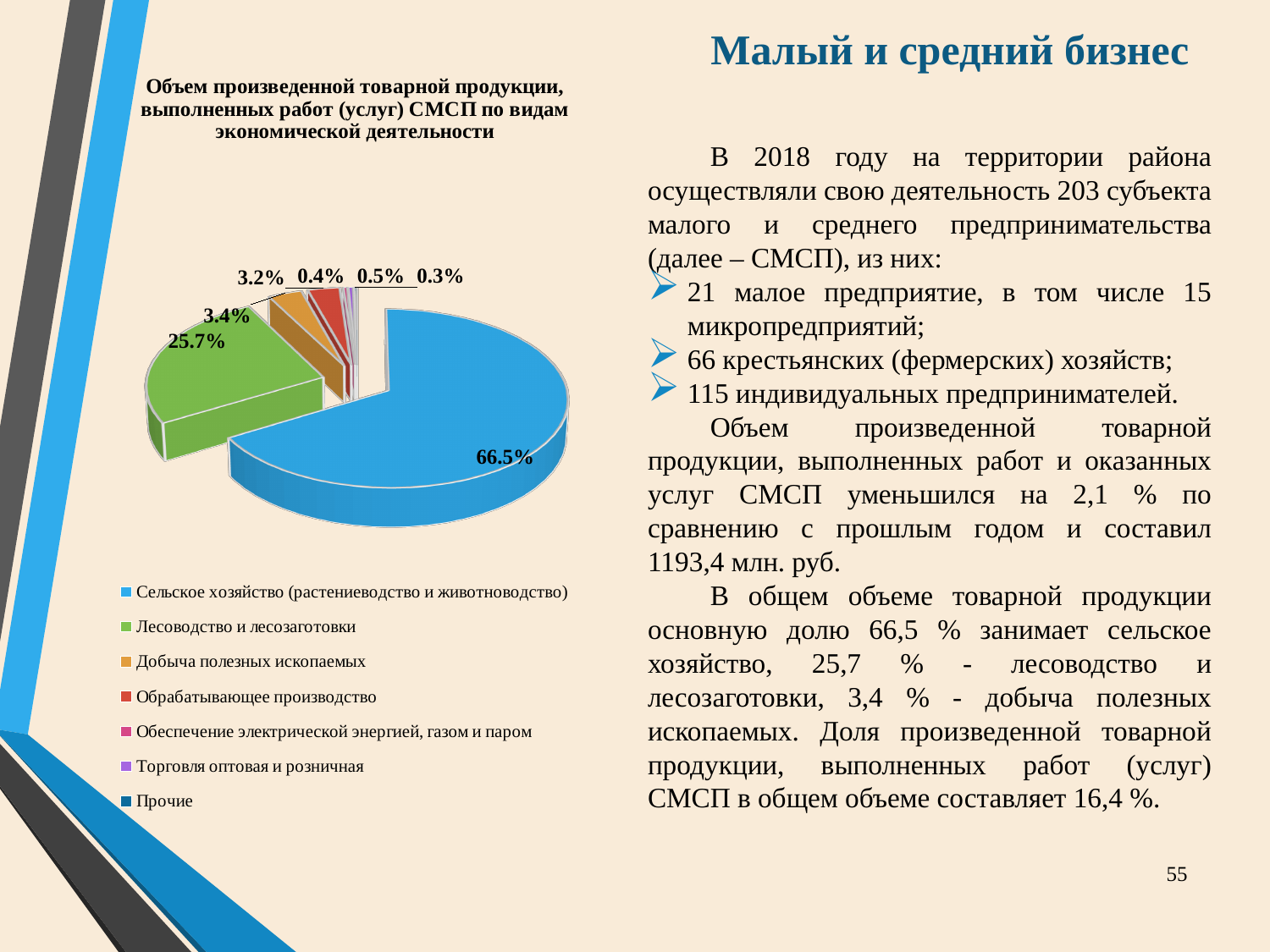
How many categories does the pie chart legend list? 7 What is the difference between the shares of Сельское хозяйство and Лесоводство и лесозаготовки? 40.8% What share of the pie does Обрабатывающее производство have? 3.2% Which is larger: the share of Добыча полезных ископаемых or the share of Обрабатывающее производство? Добыча полезных ископаемых What type of chart is shown on the slide? pie chart What is the title of the pie chart? Объем произведенной товарной продукции, выполненных работ (услуг) СМСП по видам экономической деятельности Which category has the largest share of the pie? Сельское хозяйство (растениеводство и животноводство) What share of the pie does Лесоводство и лесозаготовки have? 25.7% Which category has the smallest share of the pie? Прочие What share of the pie does Добыча полезных ископаемых have? 3.4% What colour is the slice for Лесоводство и лесозаготовки? green What share of the pie does Сельское хозяйство (растениеводство и животноводство) have? 66.5%